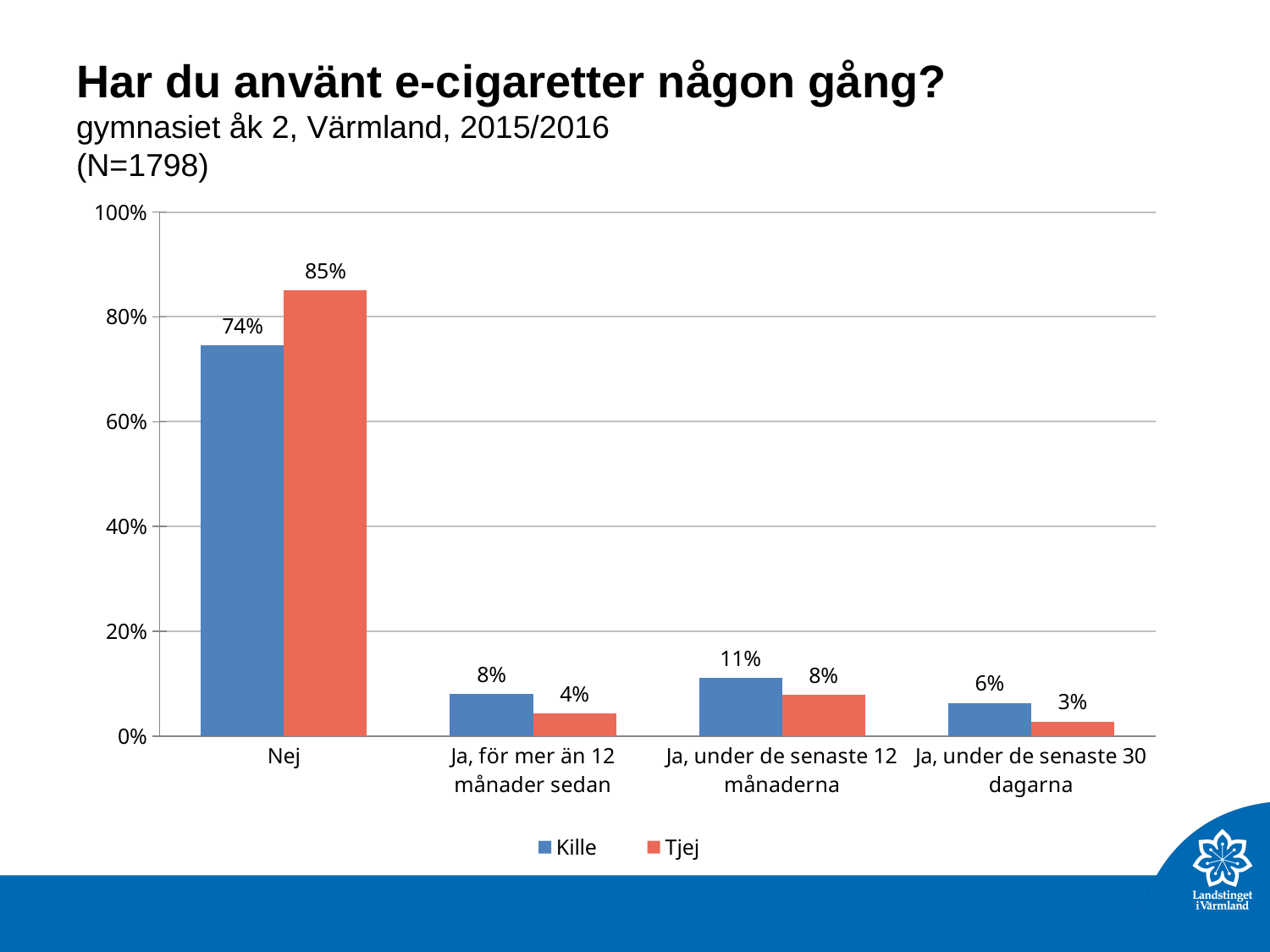
Which category has the highest value for Tjej? Nej What are the two series named in the legend? Kille and Tjej How many categories are shown on the x axis? 4 What is the value for Kille in the "Nej" category? 74% How many series does the legend list? 2 Is the value for Kille in the "Nej" category greater or less than 60%? greater What is the value for Tjej in the "Ja, under de senaste 30 dagarna" category? 3% What is the value for Tjej in the "Ja, för mer än 12 månader sedan" category? 4% Which category has the lowest value for Kille? Ja, under de senaste 30 dagarna What is the difference between the Tjej and Kille values in the "Nej" category? 11% What kind of chart is shown on the slide? bar chart In the "Ja, under de senaste 12 månaderna" category, which series has the larger value, Kille or Tjej? Kille